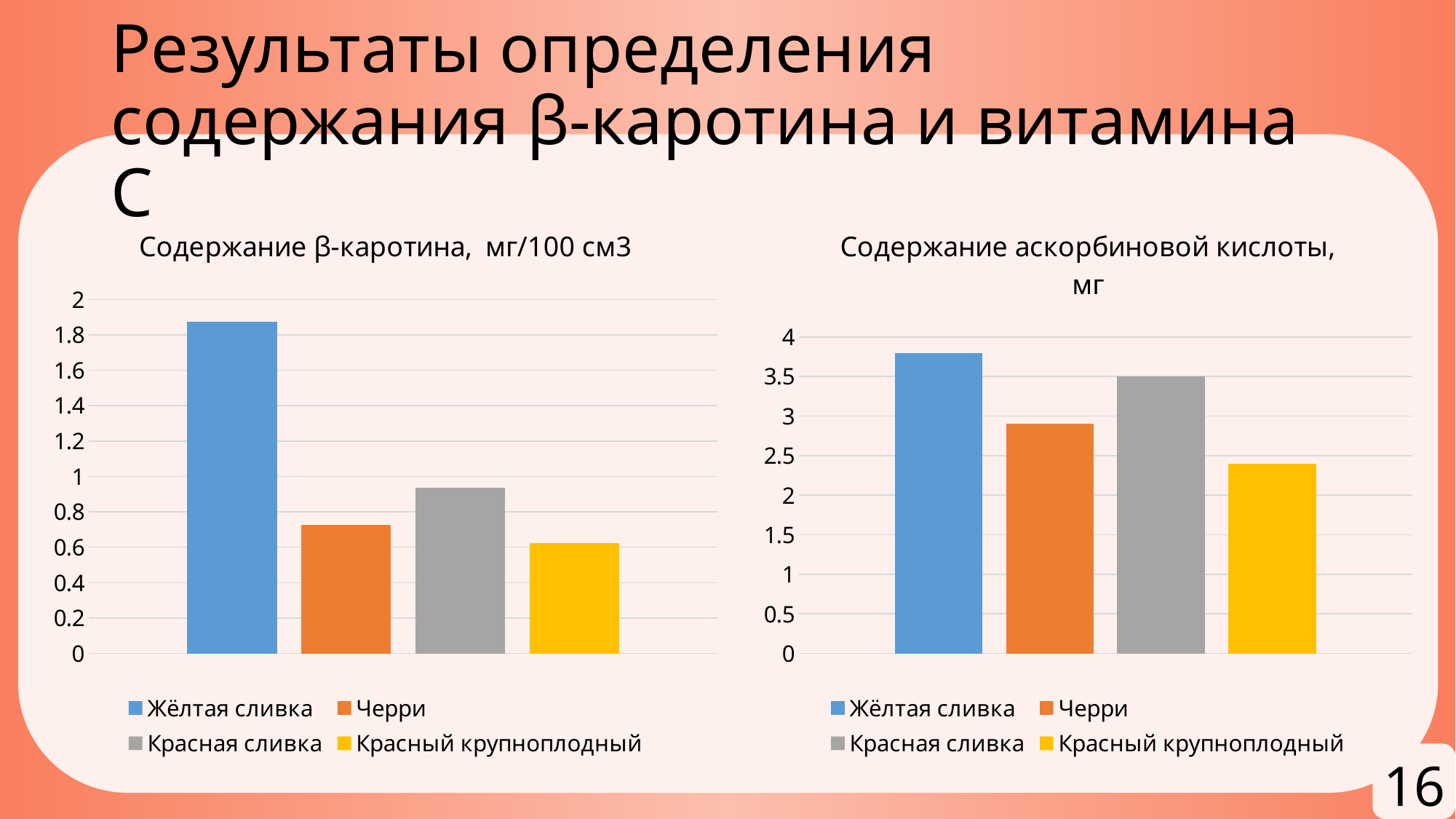
In the chart titled "Содержание β-каротина, мг/100 см3", which is larger: Красная сливка or Черри? Красная сливка In the chart titled "Содержание аскорбиновой кислоты, мг", which series has the lowest value? Красный крупноплодный What kind of chart is the chart titled "Содержание β-каротина, мг/100 см3"? bar chart In the chart titled "Содержание аскорбиновой кислоты, мг", which is larger: Красная сливка or Черри? Красная сливка In the chart titled "Содержание β-каротина, мг/100 см3", which series has the lowest value? Красный крупноплодный In the chart titled "Содержание аскорбиновой кислоты, мг", is the value for Жёлтая сливка greater or less than 3.5? greater In the chart titled "Содержание аскорбиновой кислоты, мг", is the value for Черри greater or less than 3? less In the chart titled "Содержание аскорбиновой кислоты, мг", which series has the highest value? Жёлтая сливка In the chart titled "Содержание β-каротина, мг/100 см3", is the value for Жёлтая сливка greater or less than 1.8? greater In the chart titled "Содержание β-каротина, мг/100 см3", which series has the highest value? Жёлтая сливка How many series does the legend of the chart titled "Содержание аскорбиновой кислоты, мг" list? 4